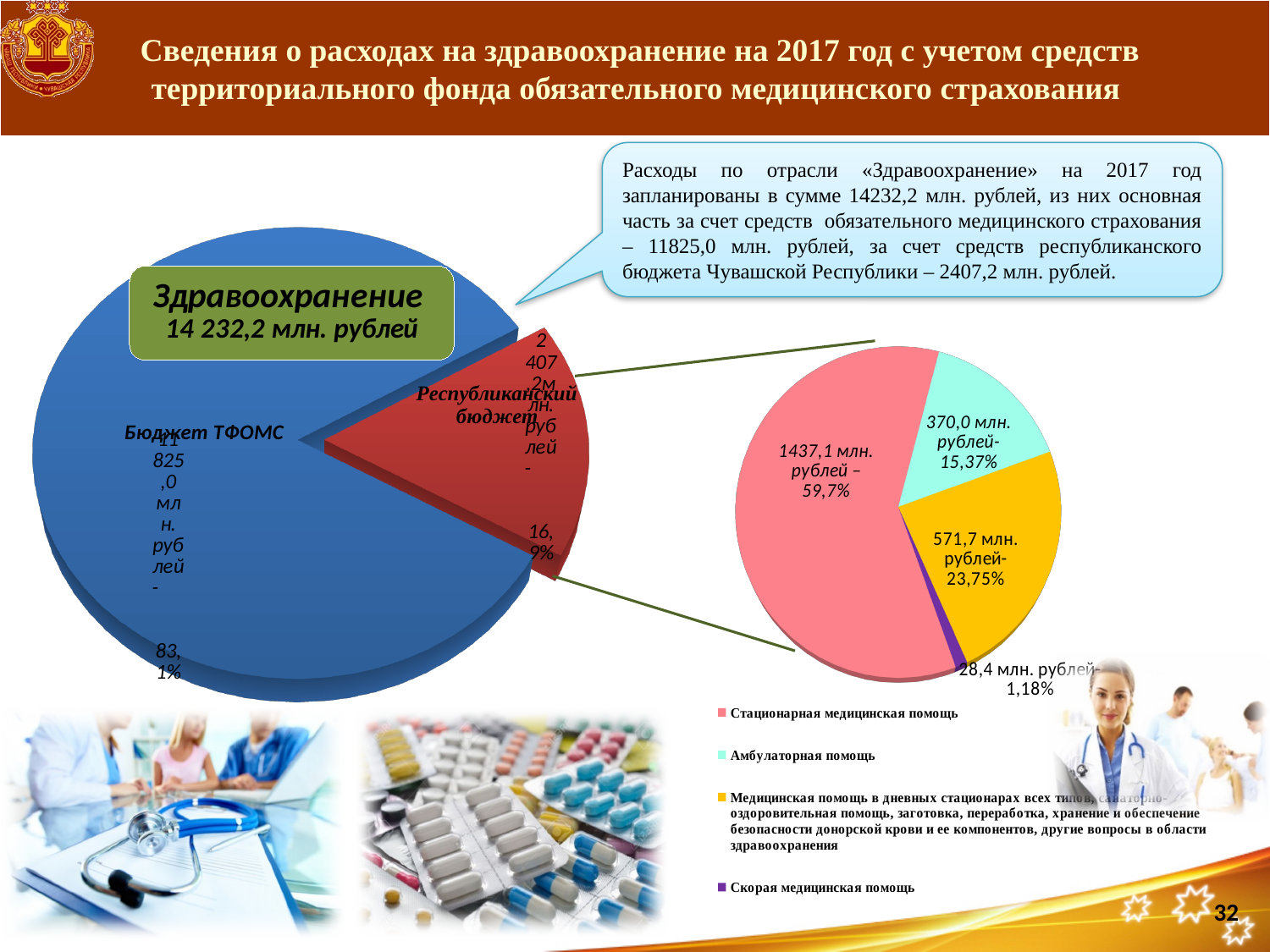
What type of chart is the left chart on the slide? pie chart In the left pie chart, what is the value for Бюджет ТФОМС? 11 825,0 млн. рублей How many categories does the legend of the right pie chart list? 4 In the right pie chart, which category has the smallest slice? Скорая медицинская помощь In the right pie chart, what share does Амбулаторная помощь have? 15,37% In the left pie chart, which slice is larger: Бюджет ТФОМС or Республиканский бюджет? Бюджет ТФОМС In the right pie chart, what share does Скорая медицинская помощь have? 1,18% In the right pie chart, which category has the largest slice? Стационарная медицинская помощь How many slices does the left pie chart have? 2 In the right pie chart, what is the value for Стационарная медицинская помощь? 1437,1 млн. рублей In the left pie chart, what share does Бюджет ТФОМС have? 83,1%